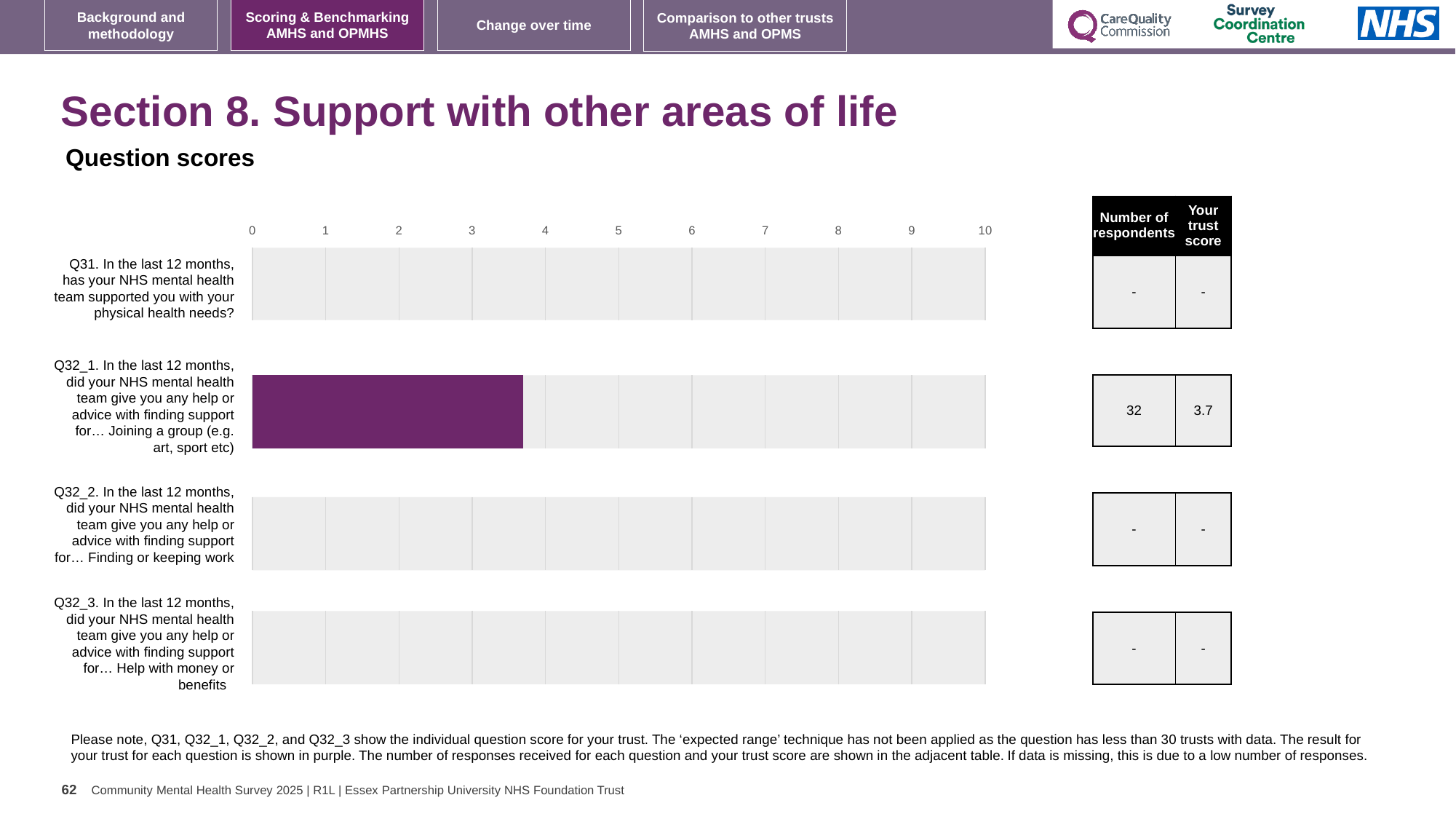
What is shown in the table for the number of respondents for Q31? - How many respondents are recorded for Q32_1? 32 How many questions on the chart have no trust score shown (marked with a dash)? 3 How many questions (categories) are listed on the chart? 4 What is the trust score shown for Q32_3 (help with money or benefits)? - What is the trust score for Q32_1 (help or advice with joining a group)? 3.7 What colour is the bar showing the trust's result for Q32_1? purple What is the highest value shown on the chart's x axis? 10 Is the bar for Q32_1 greater or less than 5? less Which question is the only one with a plotted bar on the chart? Q32_1 What kind of chart is shown on the slide? bar chart Is the bar for Q32_1 greater or less than 3? greater